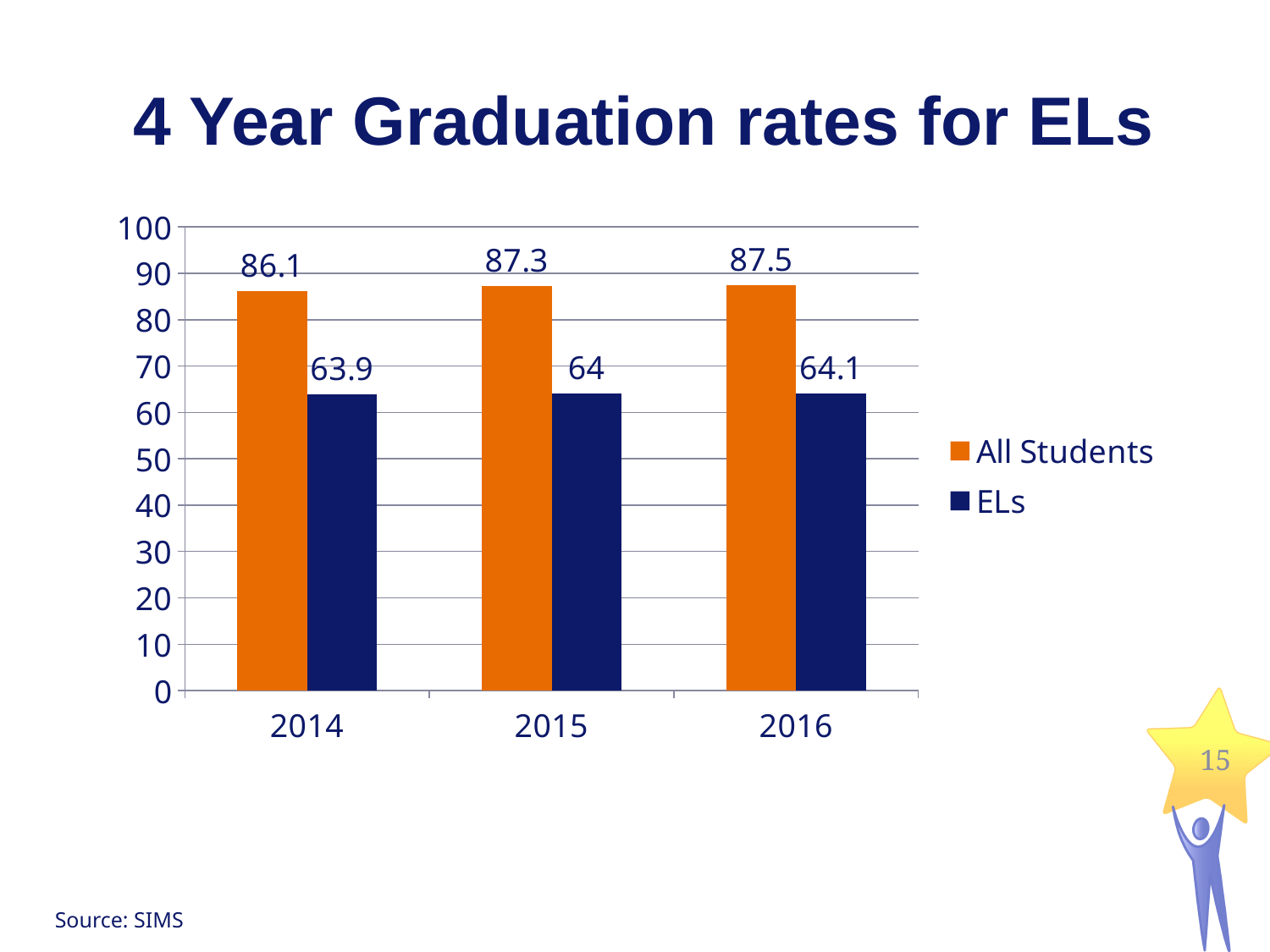
In which year is the All Students graduation rate highest? 2016 Do the ELs graduation rates rise or fall from 2014 to 2016? Rise How many series does the legend list? 2 What kind of chart is shown on the slide? Bar chart What is the value for ELs in 2015? 64 What is the 4-year graduation rate for All Students in 2014? 86.1 How many years are shown on the x axis? 3 In which year is the ELs graduation rate lowest? 2014 What is the difference between the All Students rates in 2014 and 2015? 1.2 What is the difference between the All Students and ELs rates in 2016? 23.4 What is the 4-year graduation rate for ELs in 2016? 64.1 Which is larger in 2015, the All Students rate or the ELs rate? All Students